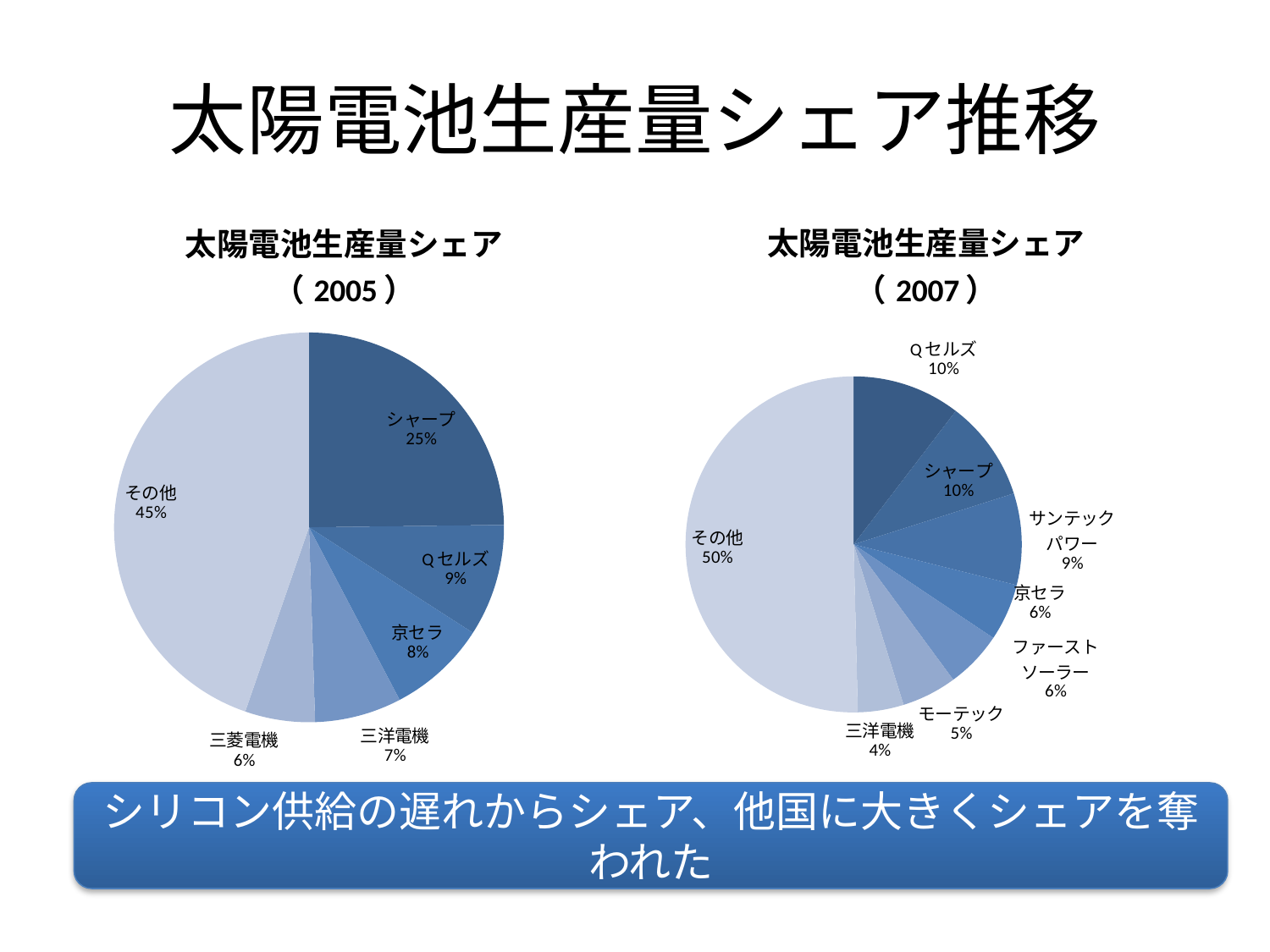
In the 太陽電池生産量シェア（2005） chart, which named company has the smallest share? 三菱電機 In the 太陽電池生産量シェア（2007） chart, what share does サンテックパワー hold? 9% In the 太陽電池生産量シェア（2005） chart, which is larger, the share of Qセルズ or the share of 京セラ? Qセルズ What type of chart is used for the 太陽電池生産量シェア（2007） data? Pie chart How many slices does the 太陽電池生産量シェア（2007） chart have? 8 In the 太陽電池生産量シェア（2005） chart, what share does シャープ hold? 25% In the 太陽電池生産量シェア（2007） chart, which slice is the smallest? 三洋電機 In the 太陽電池生産量シェア（2005） chart, which slice is the largest? その他 What is the difference between シャープ's share in the 2005 chart and its share in the 2007 chart? 15 percentage points How many slices does the 太陽電池生産量シェア（2005） chart have? 6 In the 太陽電池生産量シェア（2007） chart, what share does 三洋電機 hold? 4% In the 太陽電池生産量シェア（2007） chart, what share of the pie is その他? 50%